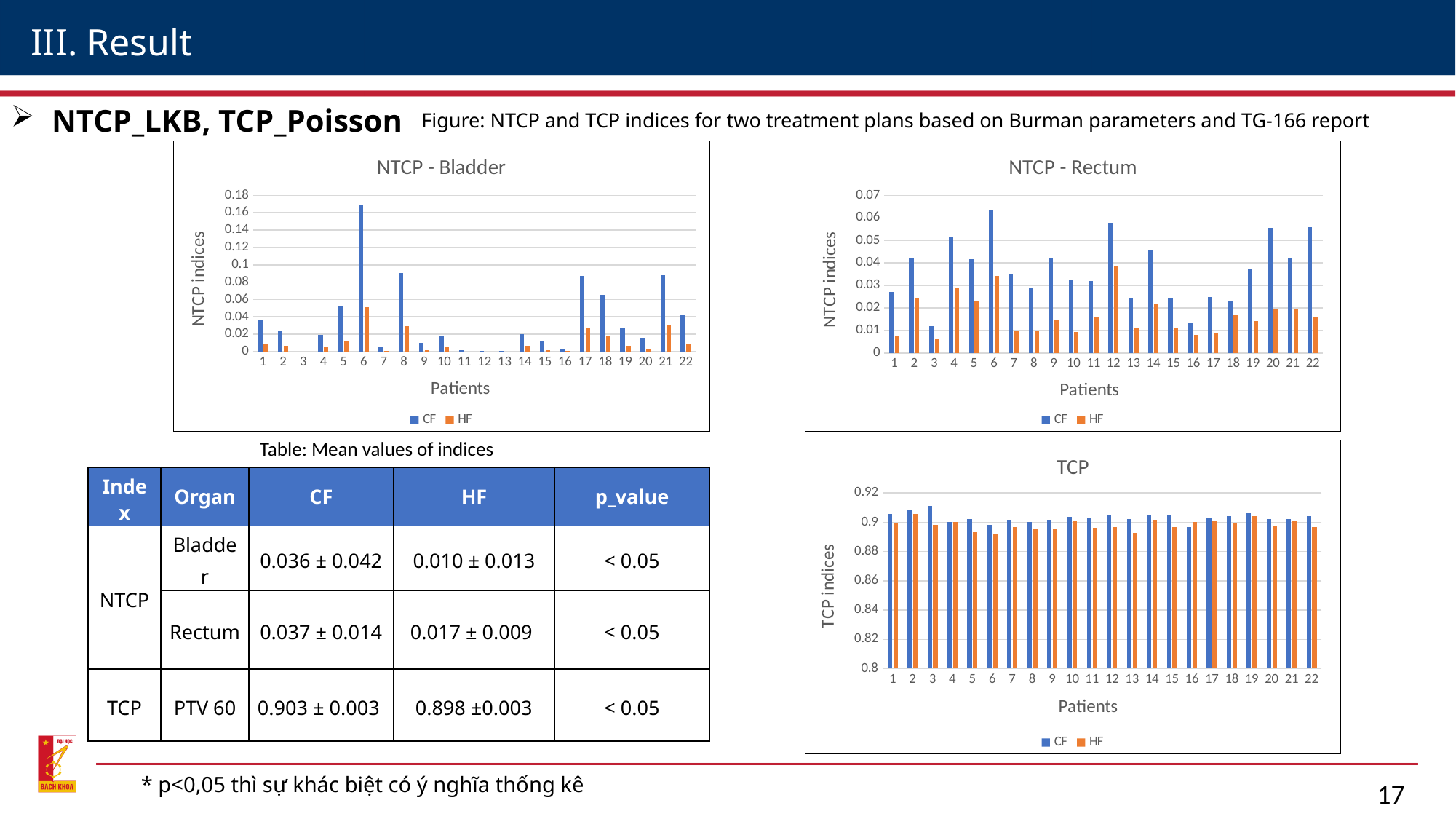
In the TCP chart, is the HF value for patient 5 greater or less than 0.9? less How many series does the legend of the NTCP - Bladder chart list? 2 In the NTCP - Rectum chart, is the CF value for patient 3 greater or less than 0.02? less In the NTCP - Bladder chart, which patient has the highest CF value? 6 How many patients are shown on the x axis of the TCP chart? 22 In the NTCP - Bladder chart, is the CF value for patient 6 greater or less than 0.14? greater In the NTCP - Bladder chart, which is larger: the CF value for patient 8 or the CF value for patient 7? patient 8 What kind of chart is the TCP chart? bar chart In the NTCP - Rectum chart, which patient has the highest HF value? 12 In the NTCP - Rectum chart, which patient has the highest CF value? 6